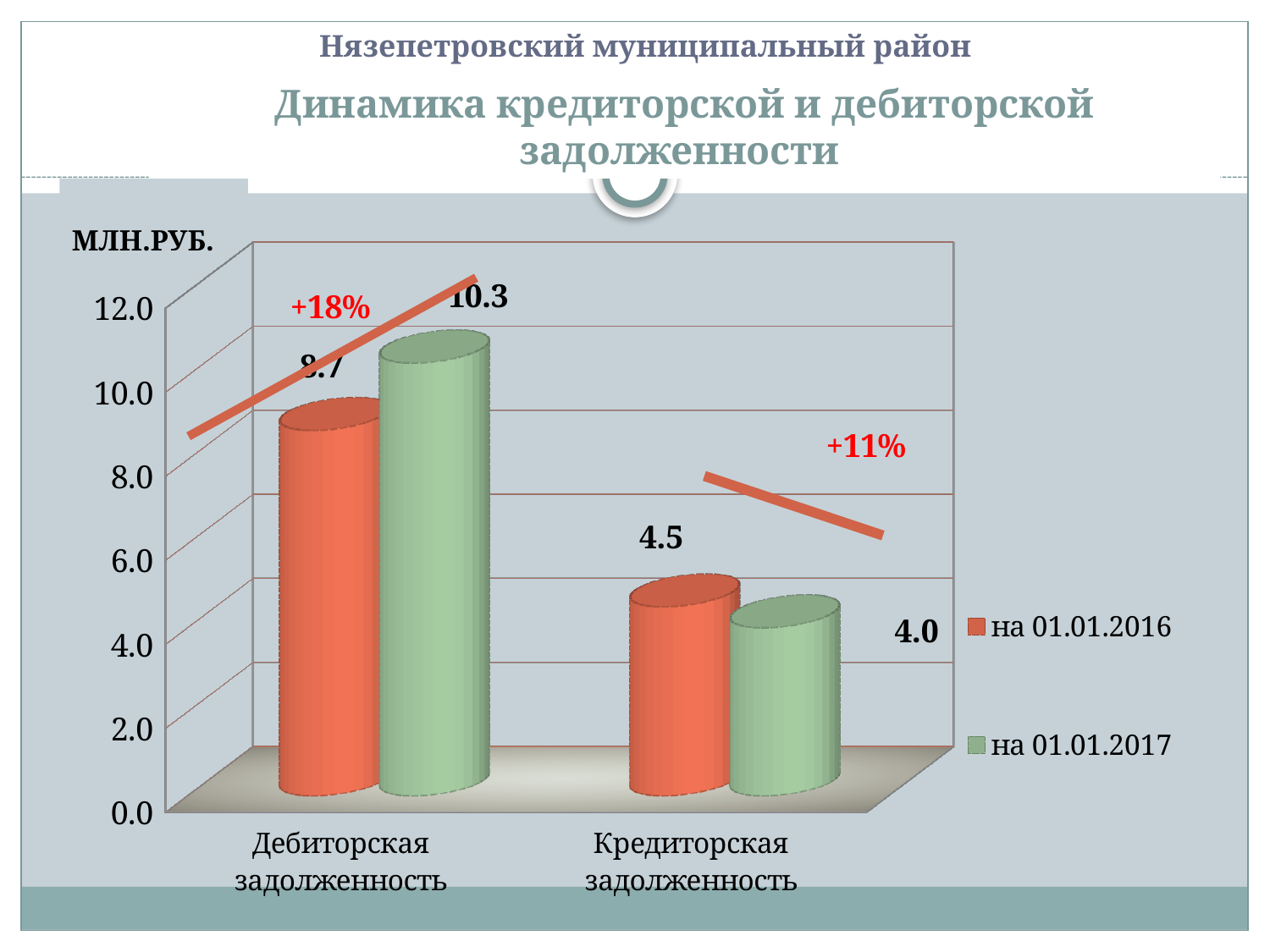
Which category has the highest value на 01.01.2017? Дебиторская задолженность Which category has the lowest value на 01.01.2016? Кредиторская задолженность How many categories are shown on the x axis? 2 What is the value of Дебиторская задолженность на 01.01.2017? 10.3 What is the difference between Кредиторская задолженность на 01.01.2016 and на 01.01.2017? 0.5 How many series does the legend list? 2 What type of chart is shown on the slide? bar chart What is the value of Кредиторская задолженность на 01.01.2016? 4.5 Is the value for Дебиторская задолженность на 01.01.2016 greater or less than 8.0? greater What unit is indicated on the vertical axis of the chart? МЛН.РУБ. Which is larger for Кредиторская задолженность: the value на 01.01.2016 or на 01.01.2017? на 01.01.2016 What is the value of Кредиторская задолженность на 01.01.2017? 4.0